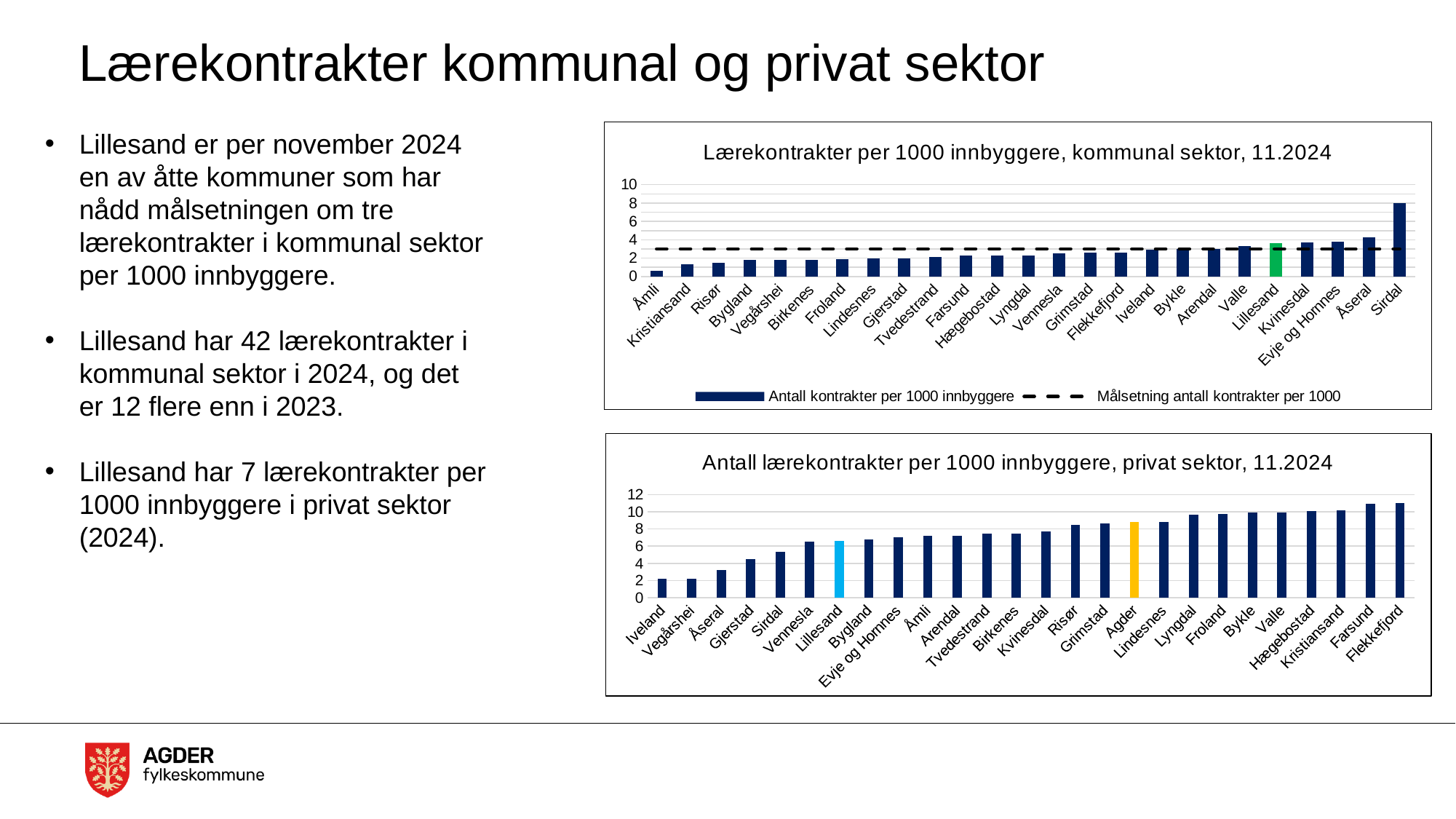
What kind of chart is the bottom chart (privat sektor)? Bar chart How many municipalities are shown on the x axis of the top chart (kommunal sektor)? 25 In the bottom chart (privat sektor), is the value for Iveland greater or less than 4? less How many series does the legend of the top chart (kommunal sektor) list? 2 In the top chart (kommunal sektor), which municipality has the lowest value? Åmli In the top chart (kommunal sektor), is the value for Åmli greater or less than 2? less In the bottom chart (privat sektor), which is larger, the value for Flekkefjord or the value for Iveland? Flekkefjord In the top chart (kommunal sektor), which municipality has the highest number of lærekontrakter per 1000 innbyggere? Sirdal In the bottom chart (privat sektor), do the values rise or fall from left to right along the x axis? Rise In the top chart (kommunal sektor), which bar is coloured green? Lillesand In the bottom chart (privat sektor), is the value for Flekkefjord greater or less than 10? greater